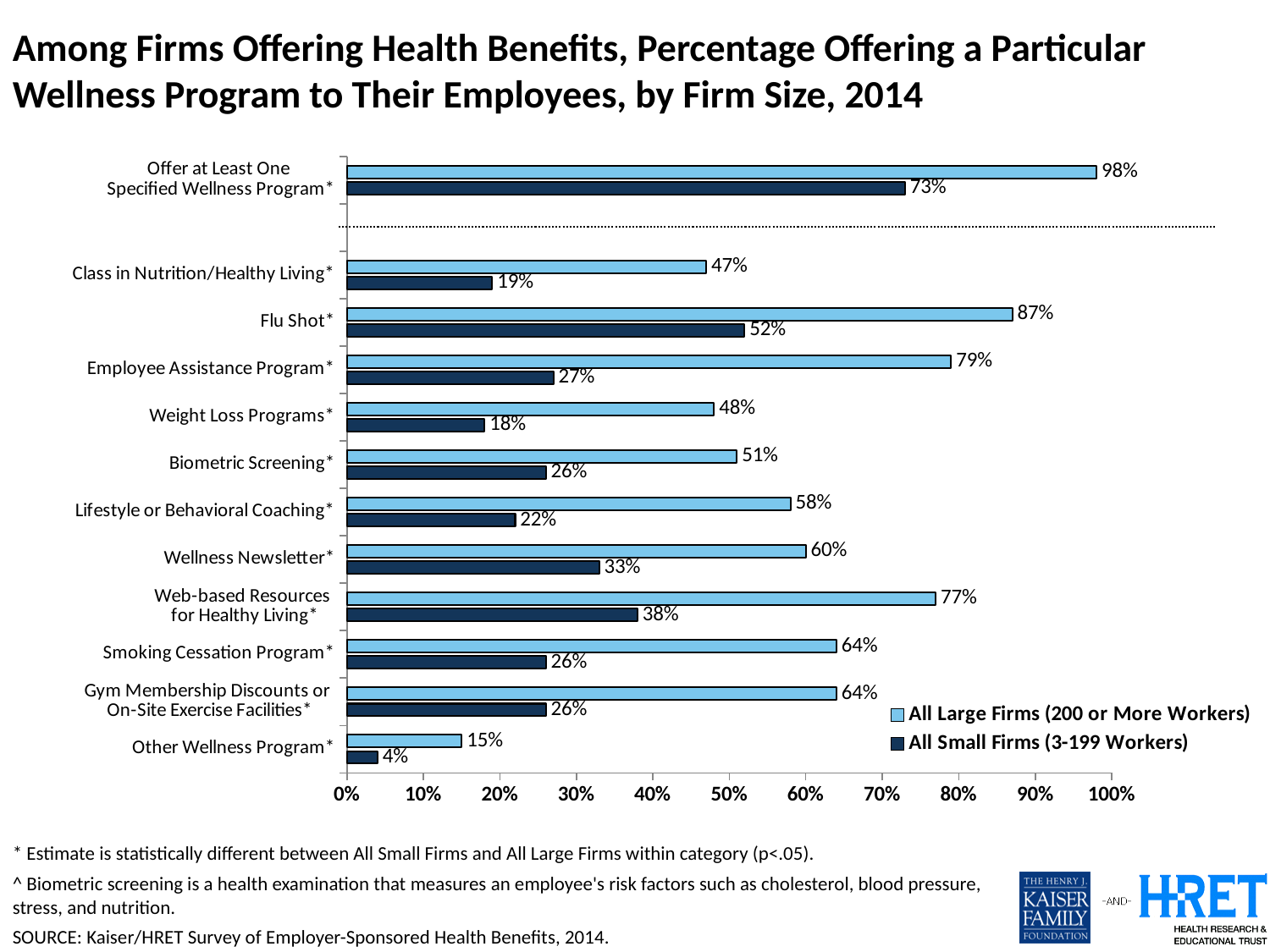
Which series is shown in the darker blue colour in the legend? All Small Firms (3-199 Workers) What percentage of All Large Firms (200 or More Workers) offer a Flu Shot? 87% What kind of chart is shown on the slide? Bar chart Which category has the lowest value for All Small Firms (3-199 Workers)? Other Wellness Program What percentage of All Large Firms offer at least one specified wellness program? 98% How many series does the legend list? 2 What percentage of All Small Firms (3-199 Workers) offer an Other Wellness Program? 4% What percentage of All Small Firms (3-199 Workers) offer Web-based Resources for Healthy Living? 38% Which is larger for All Small Firms (3-199 Workers): Wellness Newsletter or Biometric Screening? Wellness Newsletter How many categories are shown on the chart? 12 What is the difference between All Large Firms and All Small Firms for Employee Assistance Program? 52 percentage points Among the specific wellness programs listed below the dotted line, which has the highest value for All Large Firms (200 or More Workers)? Flu Shot